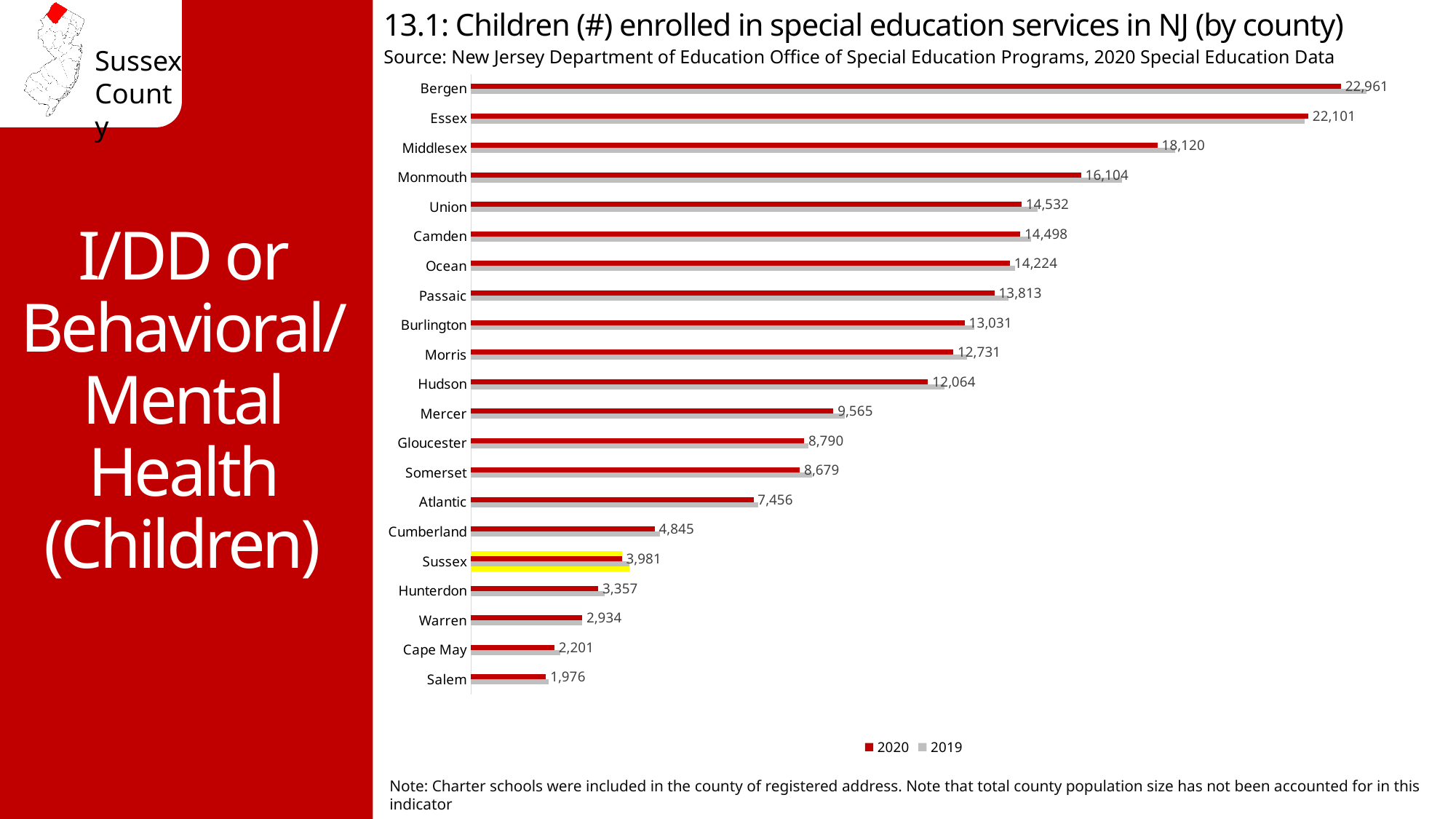
What is the 2020 value shown for Salem County? 1,976 Which county has the highest number of children enrolled in special education services in 2020? Bergen How many children were enrolled in special education services in Bergen County in 2020? 22,961 Which county's bars are highlighted in yellow on the chart? Sussex Which county has the lowest number of children enrolled in special education services in 2020? Salem What is the difference between the 2020 values for Bergen and Essex? 860 How many series does the legend list? 2 What kind of chart is shown on the slide? Bar chart What is the difference between the 2020 values for Sussex and Hunterdon? 624 Which county has a larger 2020 value, Mercer or Gloucester? Mercer How many counties are listed on the chart? 21 What is the 2020 value shown for Sussex County? 3,981